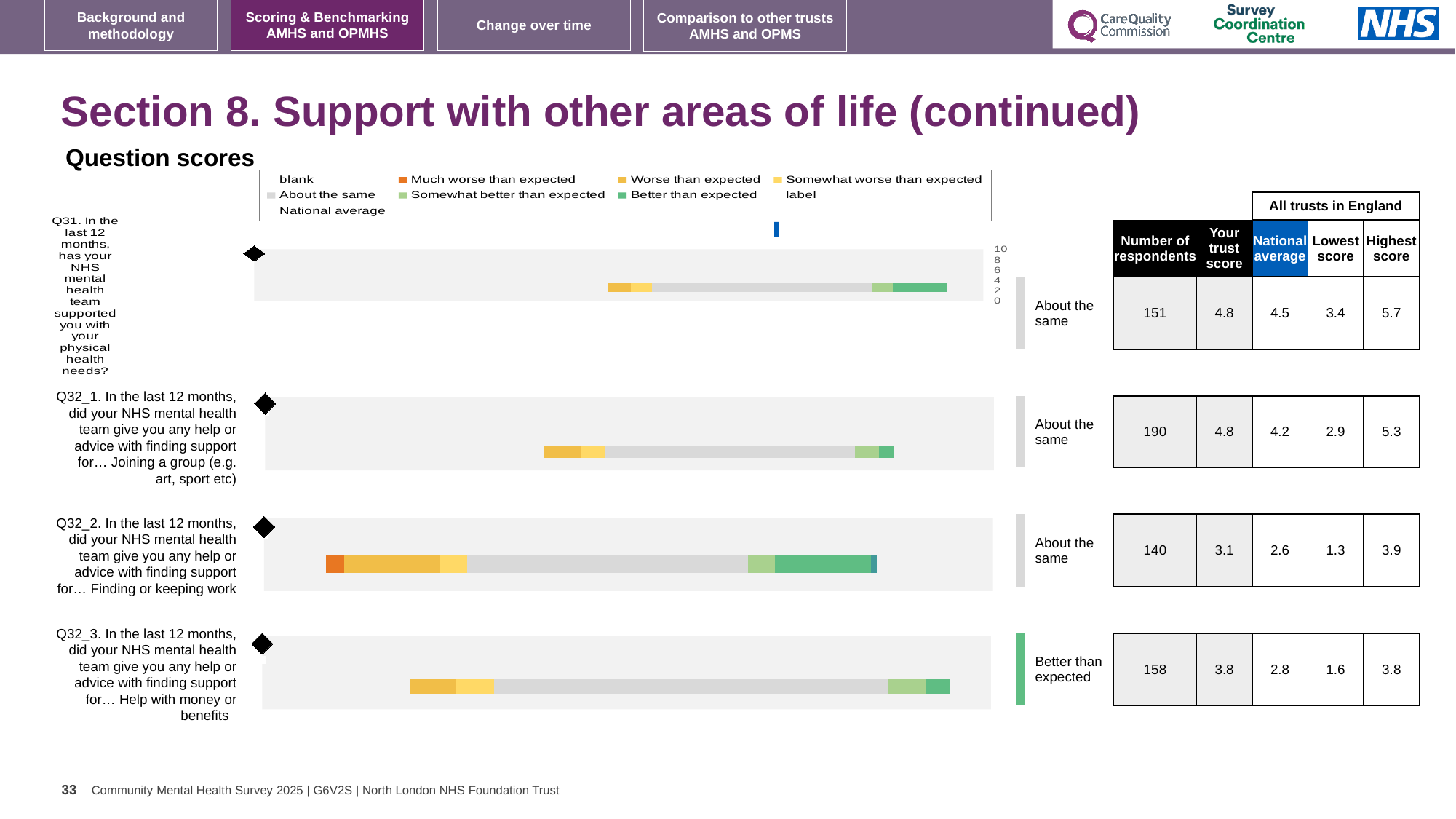
What benchmark category is shown for Q32_3 (help with money or benefits)? Better than expected Is the trust score for Q32_2 (finding or keeping work) greater or less than 4? less What is the trust score for Q32_1 (help with joining a group)? 4.8 For Q31, which is larger: the trust score or the national average? the trust score (4.8) Which question has the lowest number of respondents? Q32_2 (Finding or keeping work) What kind of chart is used to show the question scores on this slide? bar chart How many questions (bars) are shown in the question scores chart? 4 What is the national average for Q32_2 (help with finding or keeping work)? 2.6 Which question has the highest number of respondents? Q32_1 (Joining a group) What is the highest score among all trusts in England for Q32_3 (help with money or benefits)? 3.8 What is the difference between the trust score and the national average for Q32_3 (help with money or benefits)? 1.0 What is the number of respondents for Q31 (support with physical health needs)? 151